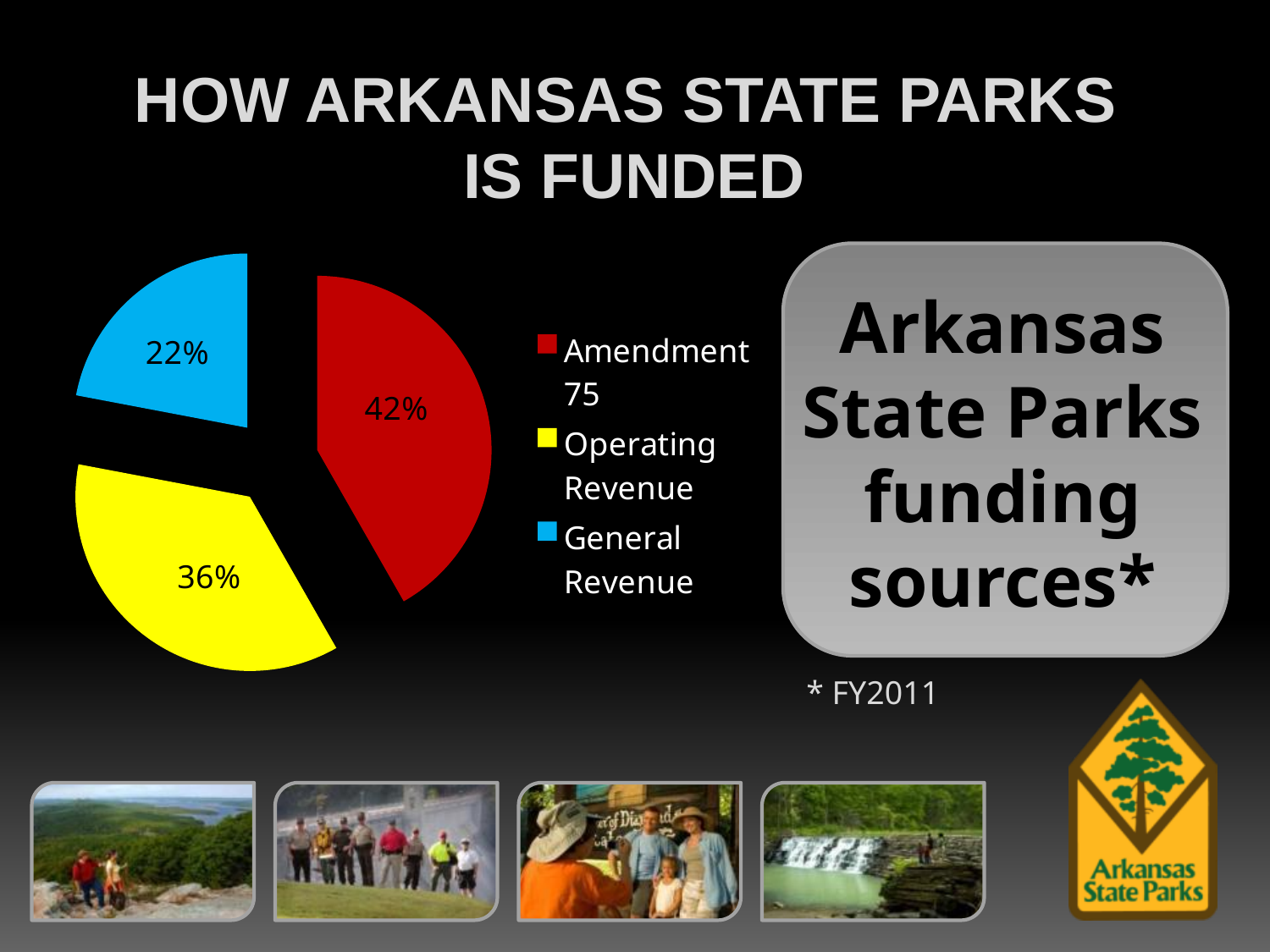
Which fiscal year does the funding sources chart refer to? FY2011 What is the difference in percentage points between the Amendment 75 share and the General Revenue share? 20 percentage points How many funding sources are shown in the pie chart? 3 What share of Arkansas State Parks funding comes from Amendment 75? 42% Which colour represents Operating Revenue in the pie chart? Yellow Which funding source has the smallest share of the pie? General Revenue Which funding source has the largest share of the pie? Amendment 75 What share of funding comes from Operating Revenue? 36% What type of chart is used to show the funding sources? Pie chart What is the difference in percentage points between the Operating Revenue share and the General Revenue share? 14 percentage points Which is larger, the Operating Revenue share or the General Revenue share? Operating Revenue What share of funding comes from General Revenue? 22%